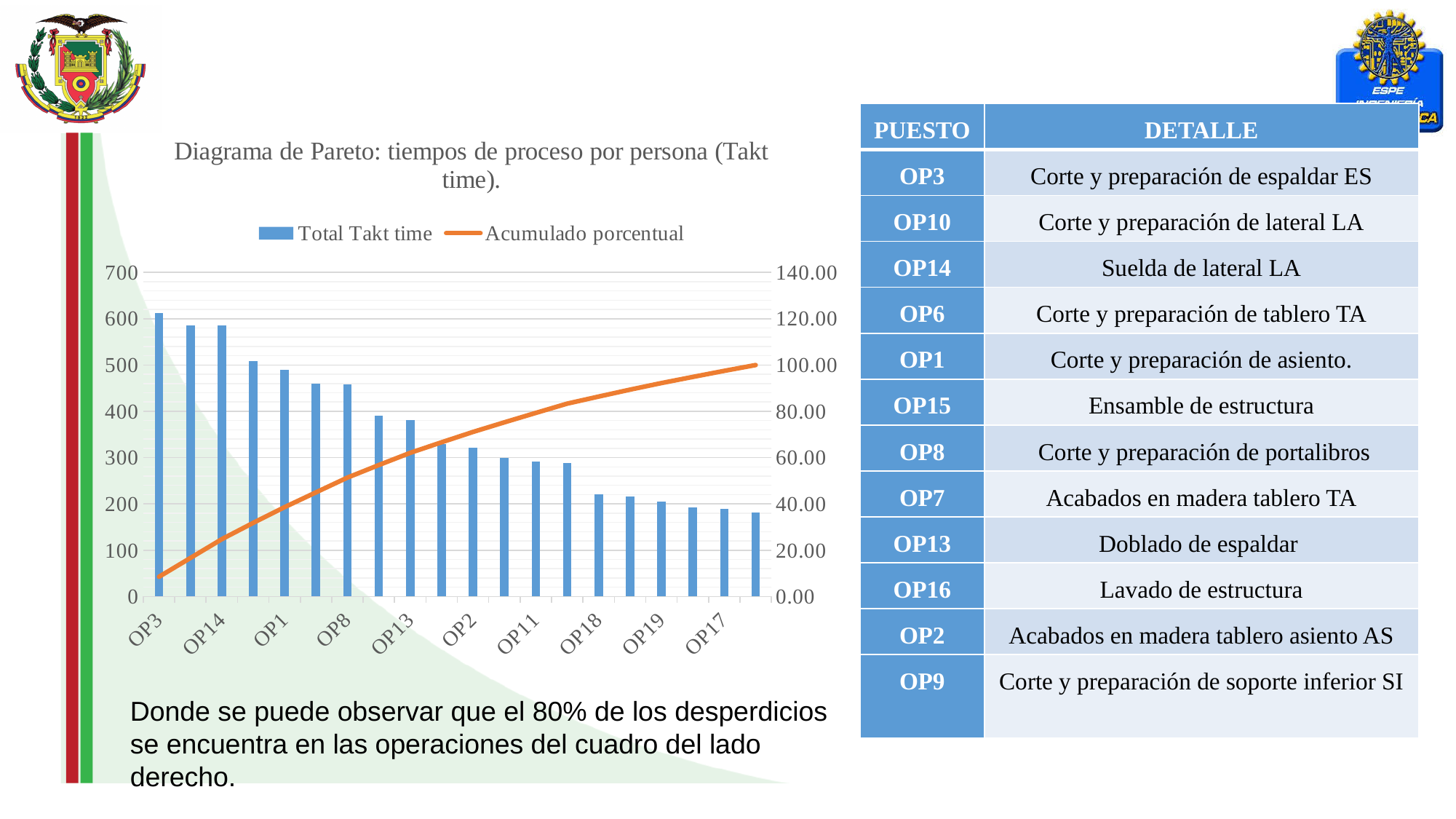
Is the Total Takt time for OP17 greater or less than 200? less Do the Total Takt time bars rise or fall from left to right along the x axis? fall Is the Total Takt time for OP3 greater or less than 600? greater What kind of chart is shown on the slide? Bar chart with a line (Pareto chart) What are the two series named in the chart legend? Total Takt time and Acumulado porcentual Is the Total Takt time for OP14 greater or less than 500? greater Which has a larger Total Takt time, OP14 or OP1? OP14 What is the title of the chart? Diagrama de Pareto: tiempos de proceso por persona (Takt time). Which operation has the highest Total Takt time bar? OP3 How many series does the chart legend list? 2 Does the Acumulado porcentual line rise or fall from left to right? rise